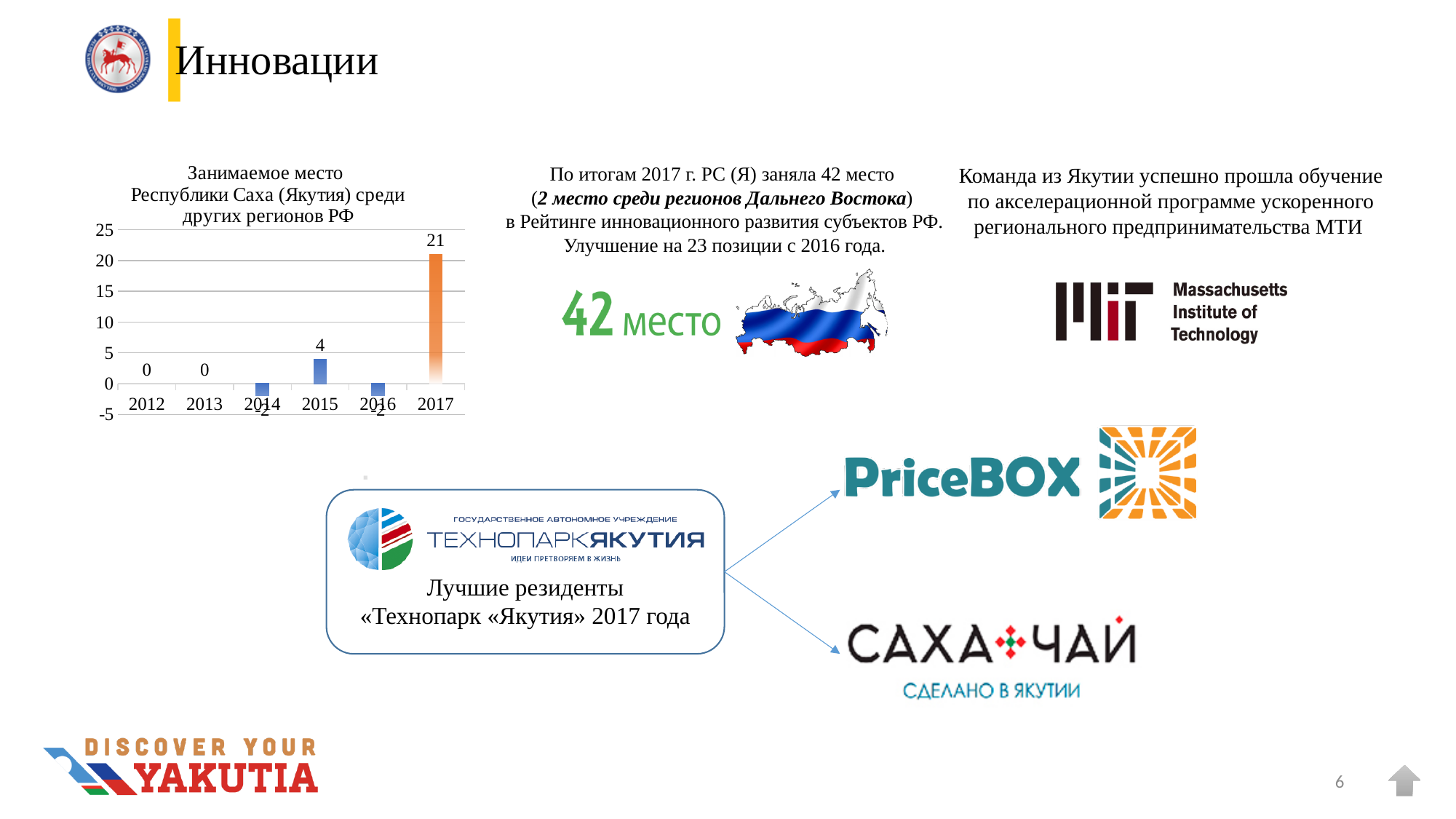
What is the value for 2015 in the chart? 4 What is the title of the chart? Занимаемое место Республики Саха (Якутия) среди других регионов РФ What is the difference between the values for 2015 and 2014? 6 What is the value for 2017 in the chart? 21 What is the difference between the values for 2017 and 2015? 17 What is the value for 2014 in the chart? -2 What type of chart is shown on the slide? bar chart Which is larger, the value for 2015 or the value for 2016? 2015 What is the value for 2012 in the chart? 0 Is the value for 2017 greater or less than 20? greater Which year has the highest value in the chart? 2017 How many years are shown on the x axis of the chart? 6